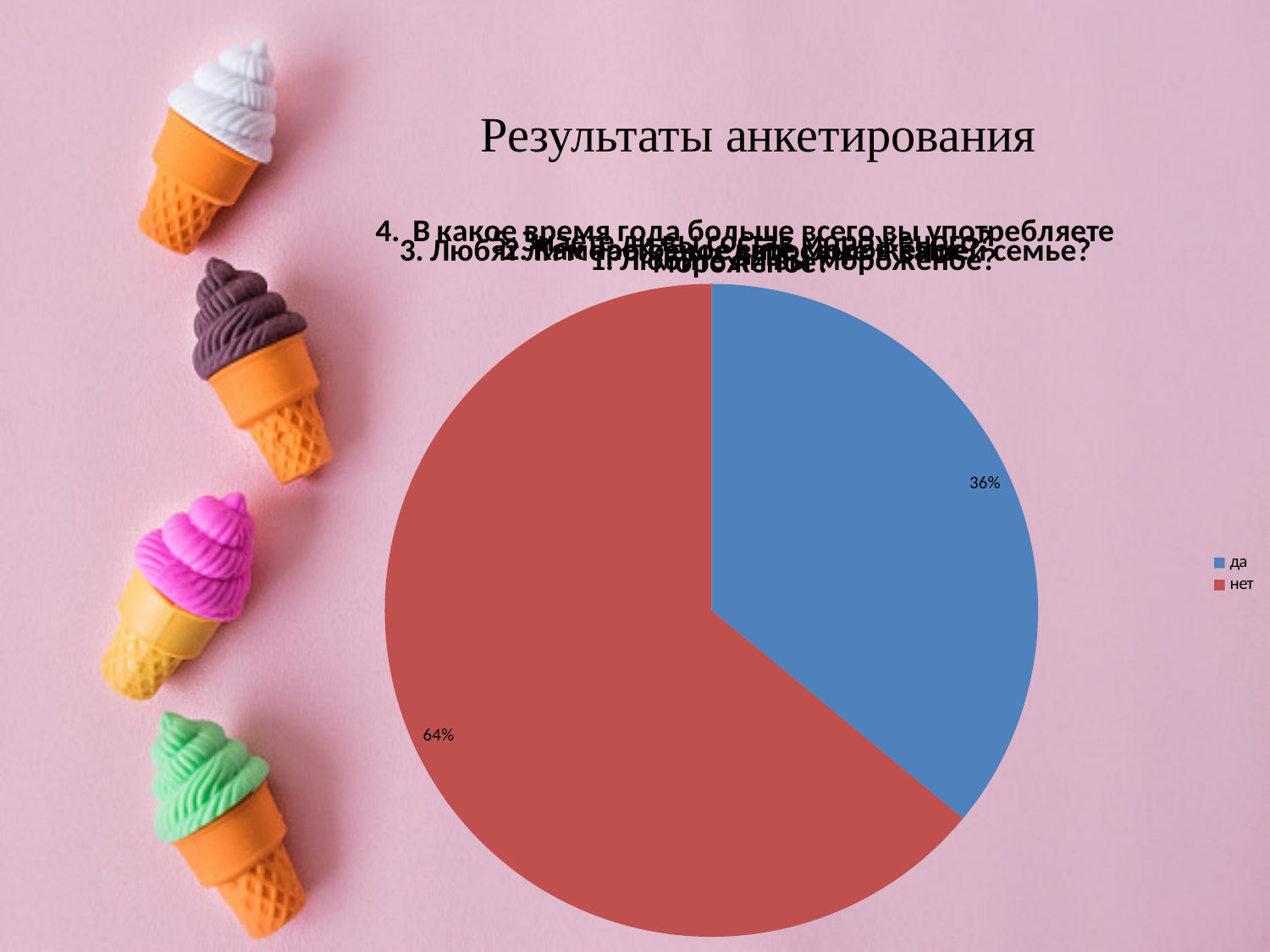
What share of the pie does the "да" slice represent? 36% How many entries does the legend list? 2 What kind of chart is shown on the slide? pie chart Is the share of the "да" slice greater or less than 50%? less What colour is the "нет" slice in the pie chart? red What is the difference in percentage points between the "нет" and "да" slices? 28 What share of the pie does the "нет" slice represent? 64% Which slice is the smallest in the pie chart? да Which is larger, the "да" slice or the "нет" slice? нет Which slice is the largest in the pie chart? нет What colour is the "да" slice in the pie chart? blue How many slices does the pie chart have? 2